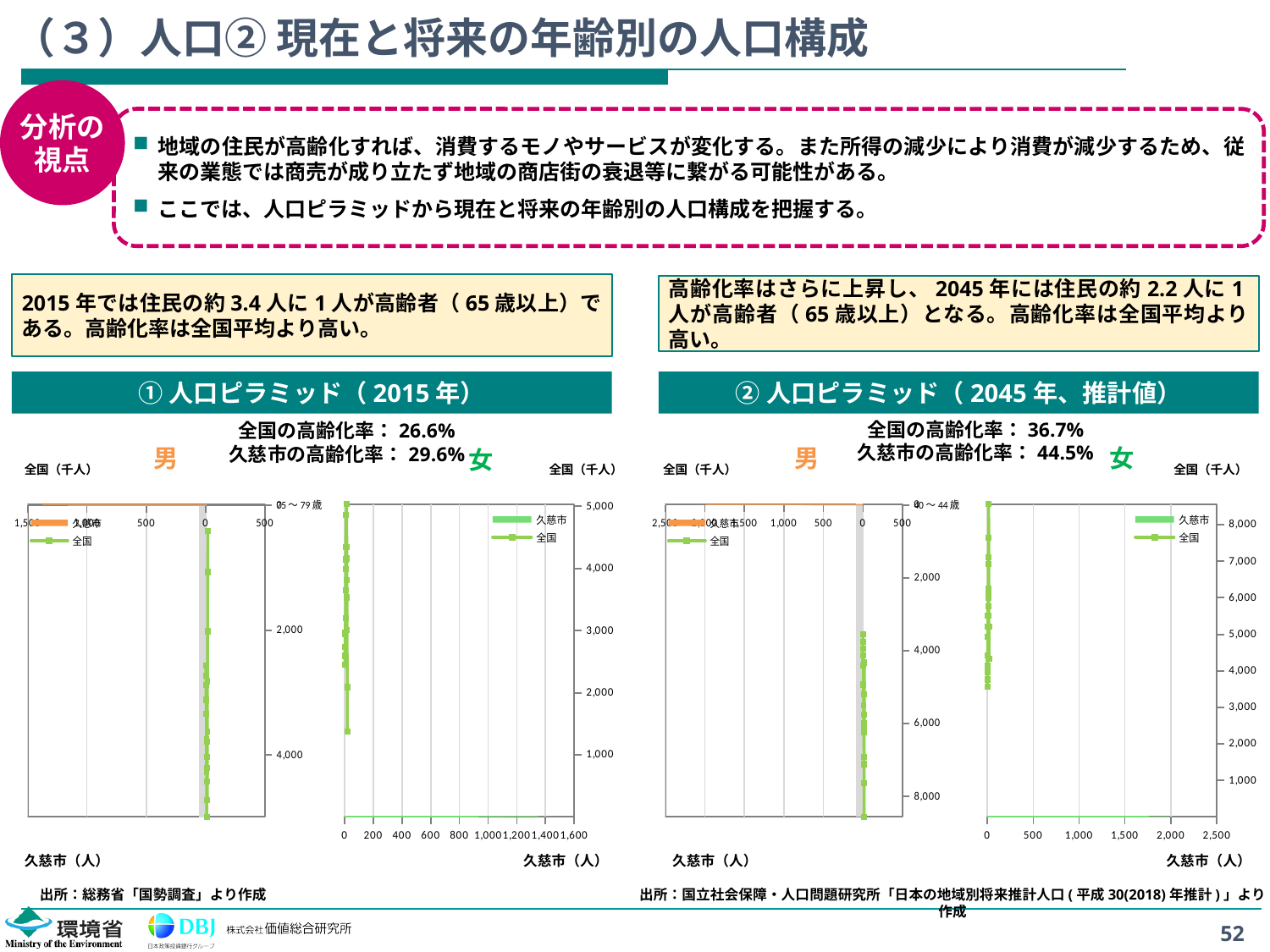
On the ① 人口ピラミッド（2015年） chart, which is higher, the 全国の高齢化率 or the 久慈市の高齢化率? 久慈市の高齢化率 On the ② 人口ピラミッド（2045年、推計値） chart, what are the two legend entries? 久慈市, 全国 What kind of chart is the ① 人口ピラミッド（2015年）? Bar chart On the ① 人口ピラミッド（2015年） chart, how many series does the legend list? 2 On the ② 人口ピラミッド（2045年、推計値） chart, what is the 全国の高齢化率 printed above the chart? 36.7% On the ① 人口ピラミッド（2015年） chart, what is the 久慈市の高齢化率 printed above the chart? 29.6% On the ① 人口ピラミッド（2015年） chart, what is the 全国の高齢化率 printed above the chart? 26.6% Comparing the two charts, is the 久慈市の高齢化率 higher in 2015 or in 2045? 2045 On the ② 人口ピラミッド（2045年、推計値） chart, what is the difference between the 久慈市の高齢化率 and the 全国の高齢化率? 7.8% On the ① 人口ピラミッド（2015年） chart, what is the difference between the 久慈市の高齢化率 and the 全国の高齢化率? 3.0% On the ② 人口ピラミッド（2045年、推計値） chart, what is the 久慈市の高齢化率 printed above the chart? 44.5%